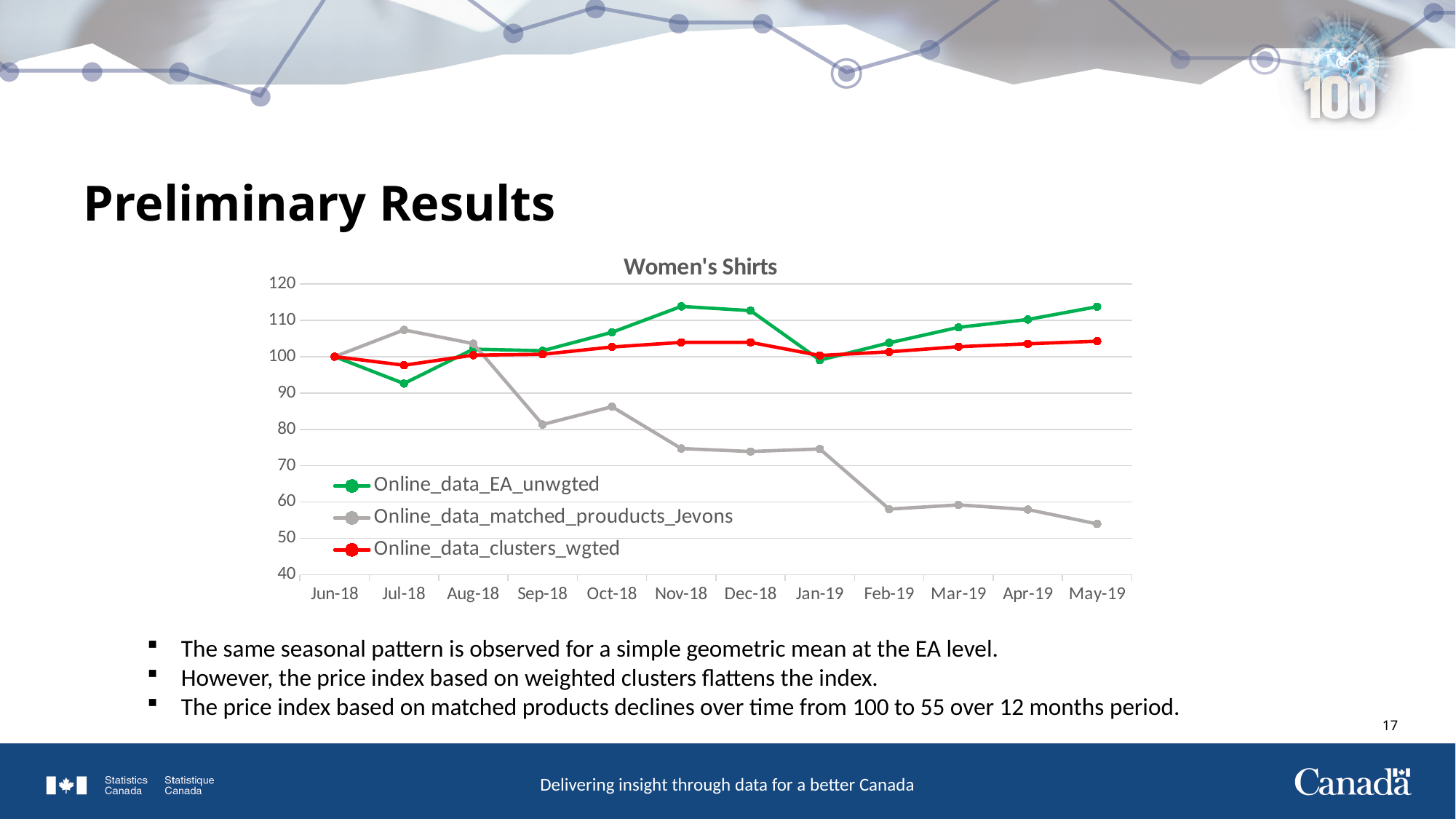
What is the title of the chart? Women's Shirts Does the Online_data_matched_prouducts_Jevons series generally rise or fall from Jun-18 to May-19? fall In Nov-18, which is higher: Online_data_EA_unwgted or Online_data_clusters_wgted? Online_data_EA_unwgted Is the value for Online_data_matched_prouducts_Jevons in Nov-18 greater or less than 70? greater How many months are plotted along the x axis? 12 What type of chart is shown on the slide? line chart How many series does the legend list? 3 Is the value for Online_data_matched_prouducts_Jevons in May-19 greater or less than 60? less In which month does Online_data_matched_prouducts_Jevons reach its highest value? Jul-18 Is the value for Online_data_EA_unwgted in Nov-18 greater or less than 110? greater What is the value of Online_data_clusters_wgted in Jun-18? 100 Which series has the lowest value in May-19? Online_data_matched_prouducts_Jevons